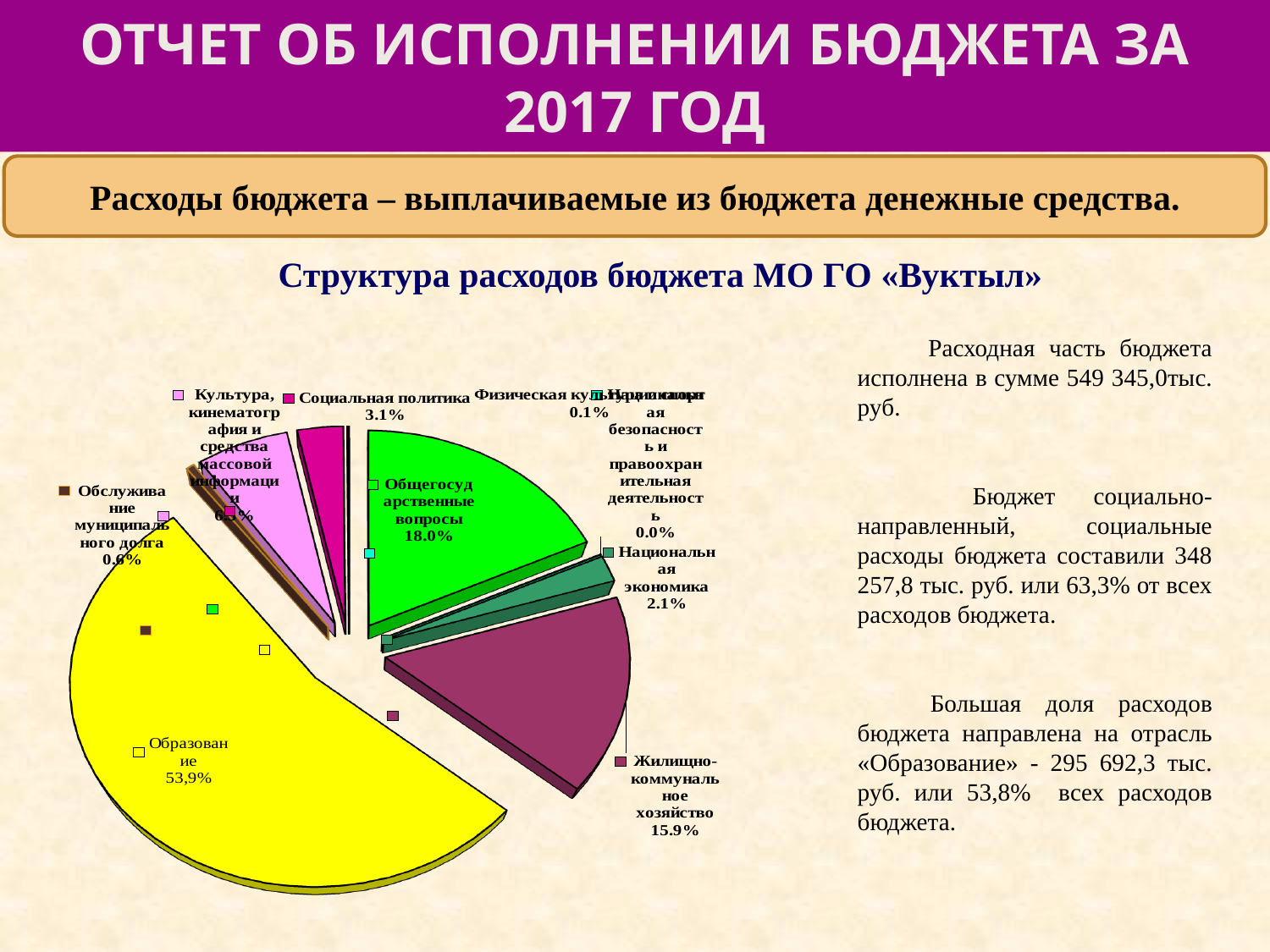
What share of the pie does Жилищно-коммунальное хозяйство have? 15.9% What is the difference between the shares for Общегосударственные вопросы and Жилищно-коммунальное хозяйство? 2.1% Which category has the largest share of the pie? Образование What share of the pie does Национальная экономика have? 2.1% What share of the pie does Образование have? 53,9% What share of the pie does Обслуживание муниципального долга have? 0.6% Which is larger, the share for Общегосударственные вопросы or for Жилищно-коммунальное хозяйство? Общегосударственные вопросы What is the title of the chart? Структура расходов бюджета МО ГО «Вуктыл» What kind of chart is shown on the slide? pie chart What share of the pie does Общегосударственные вопросы have? 18.0% What share of the pie does Социальная политика have? 3.1% What is the difference between the shares for Социальная политика and Национальная экономика? 1.0%